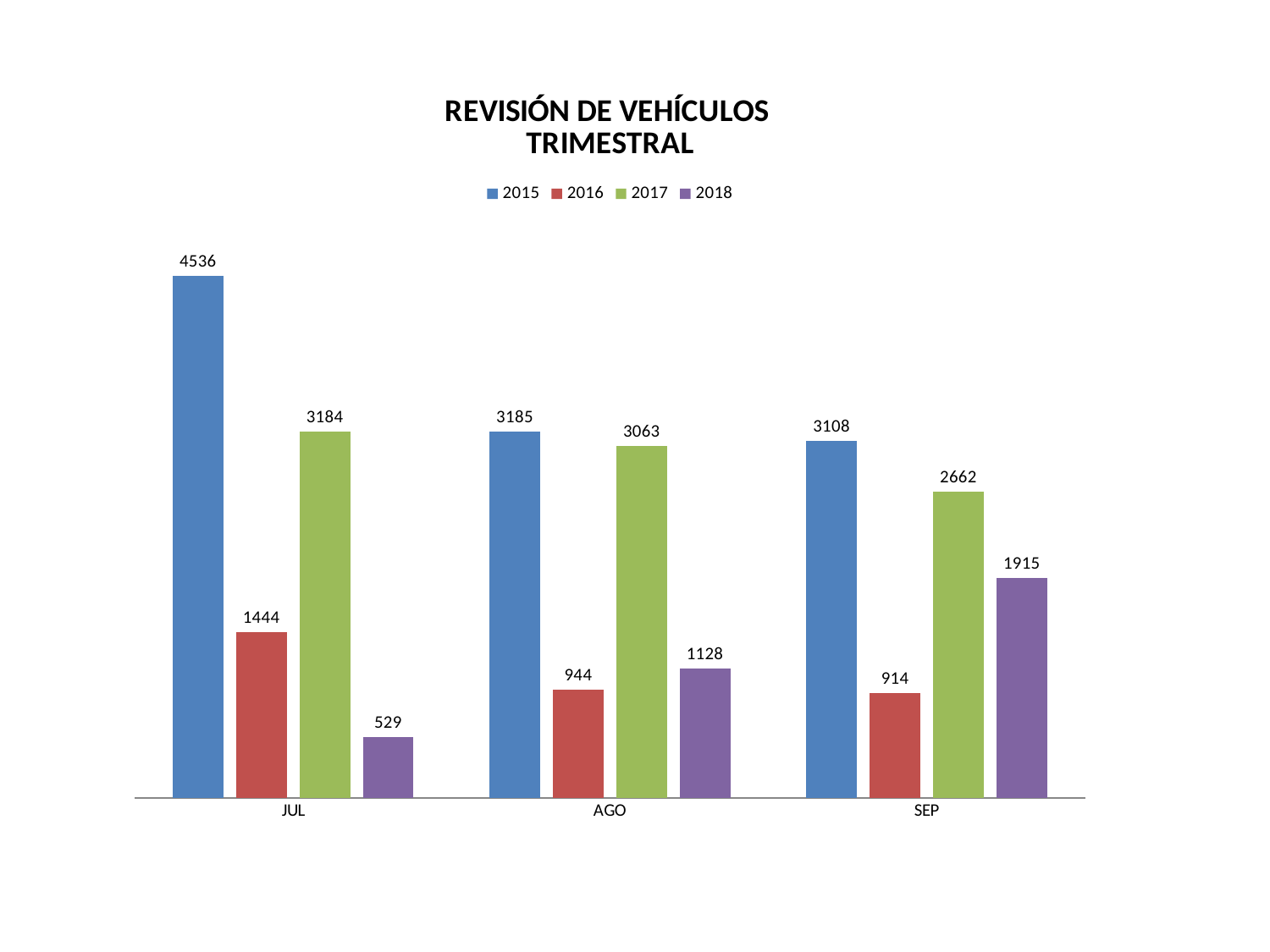
Which month has the lowest value for 2016? SEP What is the value for 2017 in SEP? 2662 How many months are shown on the x axis? 3 What is the value for 2018 in AGO? 1128 What is the difference between the 2015 and 2016 values in JUL? 3092 What kind of chart is shown? bar chart Do the values for 2015 rise or fall from JUL to SEP? fall Which month has the highest value for 2018? SEP Which is larger in SEP, the value for 2017 or the value for 2018? 2017 What is the value for 2015 in JUL? 4536 What is the title of the chart? REVISIÓN DE VEHÍCULOS TRIMESTRAL How many series does the legend list? 4